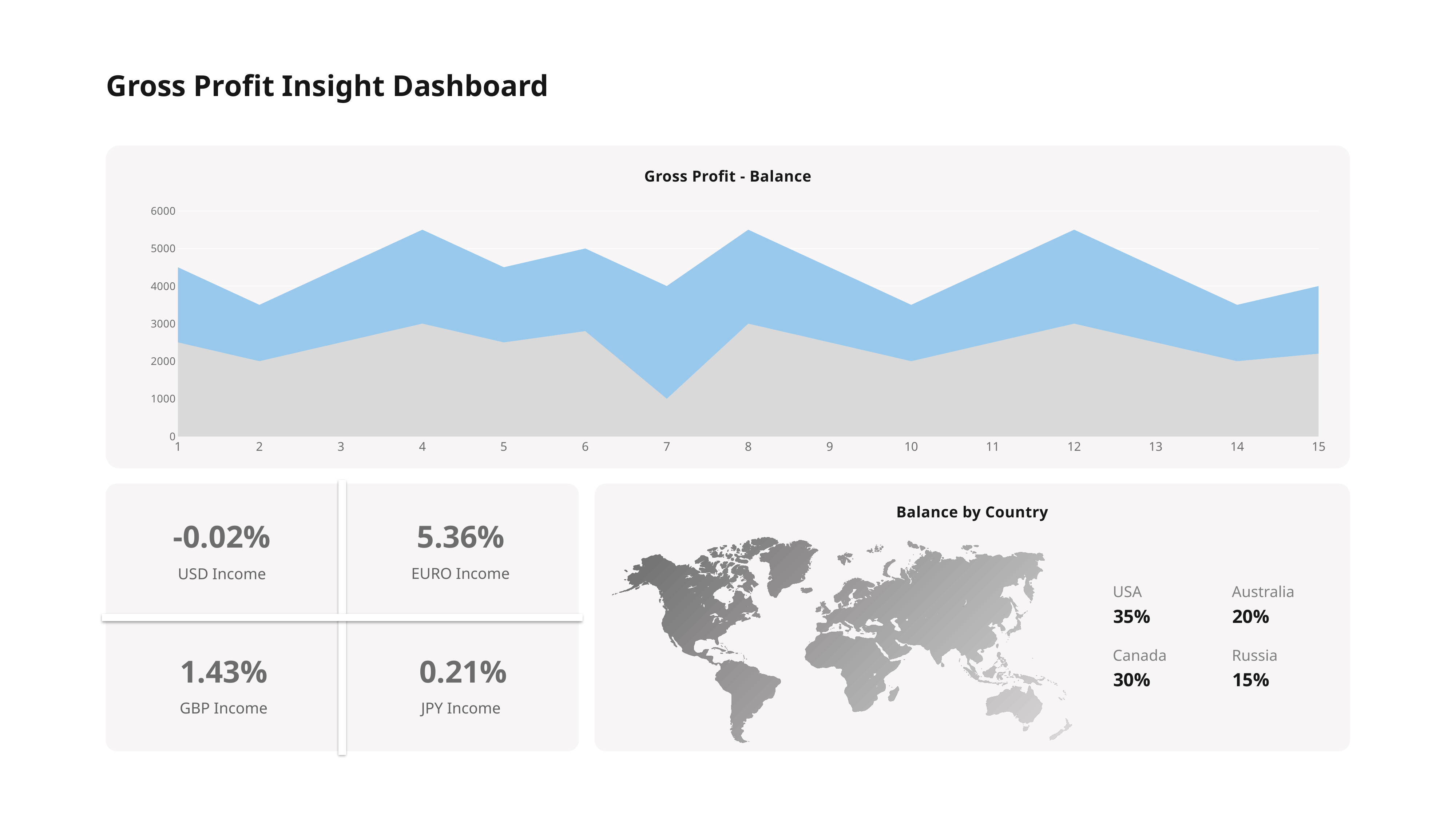
In the "Gross Profit - Balance" chart, is the lower (grey) series at point 4 greater or less than 2000? greater In the "Gross Profit - Balance" chart, is the top of the stacked area at point 4 greater or less than 5000? greater In the "Balance by Country" panel, which country has the highest value? USA In the "Gross Profit - Balance" chart, which is larger for the lower (grey) series: the value at point 7 or at point 8? point 8 In the "Balance by Country" panel, what is the value for Canada? 30% In the "Gross Profit - Balance" chart, is the top of the stacked area at point 7 greater or less than 5000? less In the "Gross Profit - Balance" chart, at which x-axis point is the lower (grey) series at its lowest? 7 What kind of chart is the "Gross Profit - Balance" chart? area chart How many points are plotted along the x axis of the "Gross Profit - Balance" chart? 15 What is the title of the chart at the top of the slide? Gross Profit - Balance